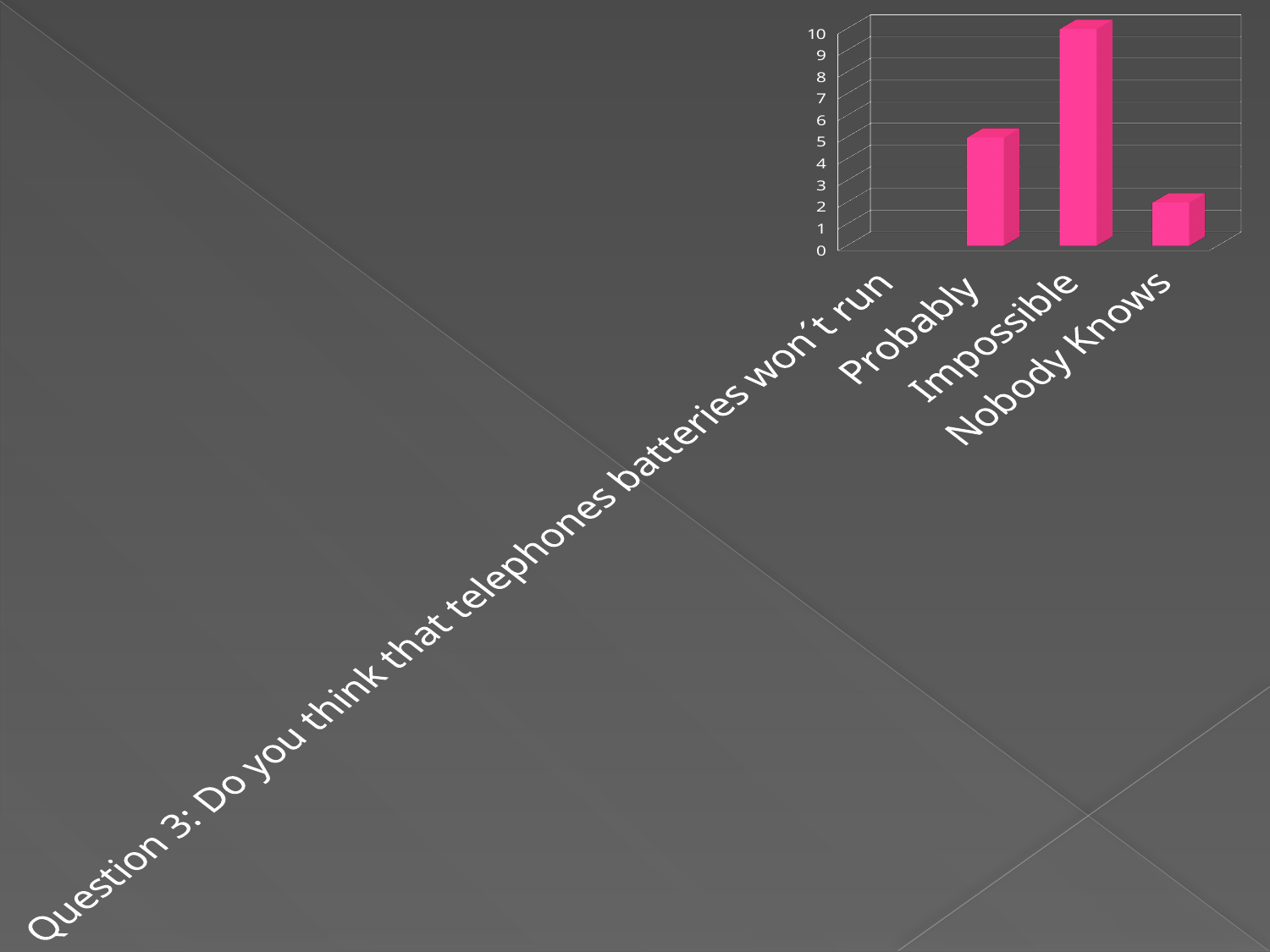
What is the difference between the values for Impossible and Probably? 5 What kind of chart is shown on the slide? bar chart Is the value for Probably greater or less than 8? less What is the value for Nobody Knows? 2 What is the value for Impossible? 10 How many categories are shown on the x axis of the chart? 4 Is the value for Nobody Knows greater or less than 4? less What is the value for Probably? 5 Which is larger, the value for Probably or the value for Nobody Knows? Probably What colour are the bars in the chart? pink Which category has the lowest bar? Nobody Knows Which category has the highest bar? Impossible